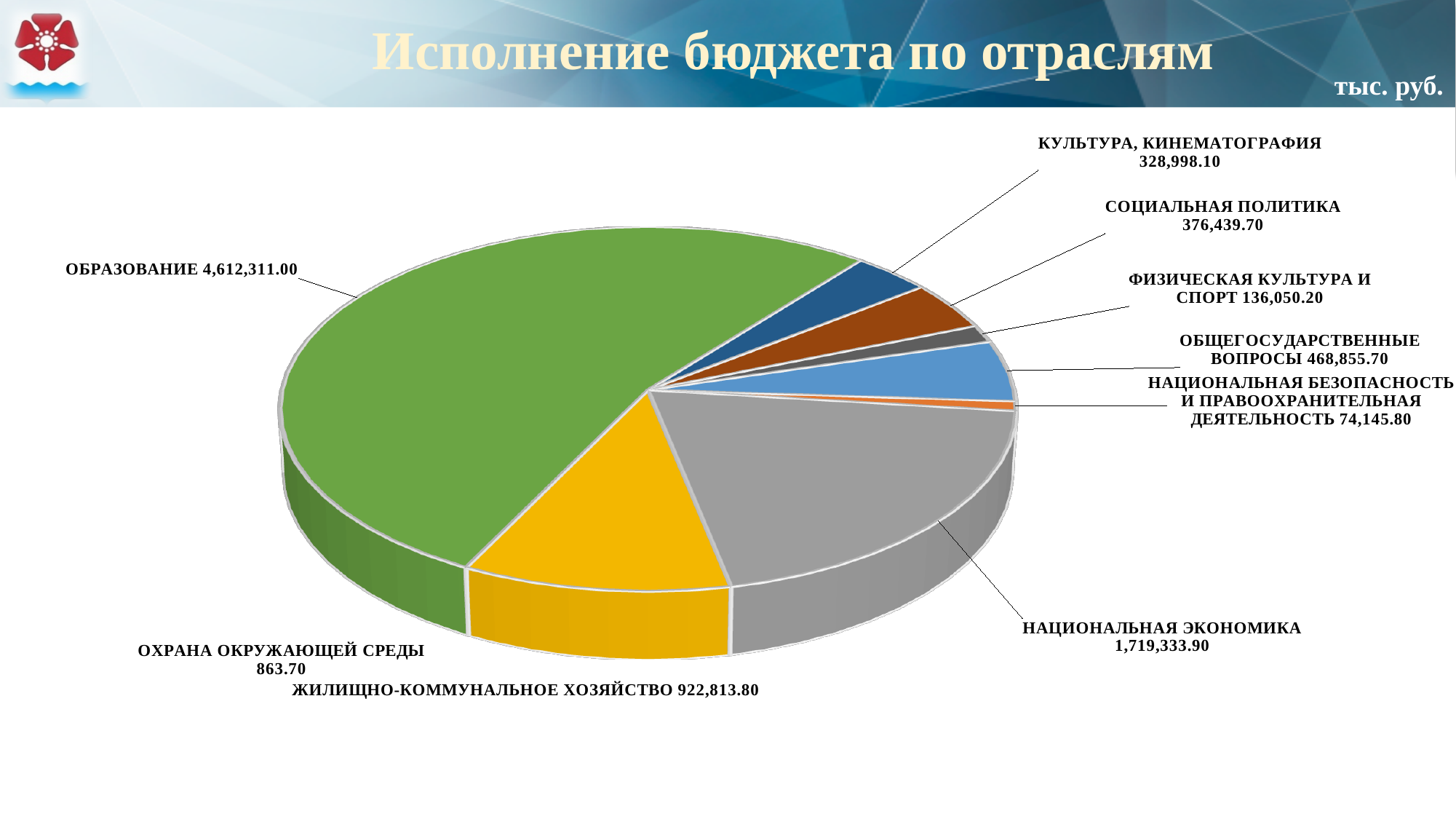
What is the difference between ОБЩЕГОСУДАРСТВЕННЫЕ ВОПРОСЫ and ФИЗИЧЕСКАЯ КУЛЬТУРА И СПОРТ? 332,805.50 What is the value for НАЦИОНАЛЬНАЯ ЭКОНОМИКА? 1,719,333.90 Which category has the largest value? ОБРАЗОВАНИЕ What kind of chart is shown on the slide? Pie chart In what units are the values on the chart given? тыс. руб. What is the value for ОБРАЗОВАНИЕ? 4,612,311.00 What is the value for ФИЗИЧЕСКАЯ КУЛЬТУРА И СПОРТ? 136,050.20 What is the title of the chart? Исполнение бюджета по отраслям What is the difference between НАЦИОНАЛЬНАЯ ЭКОНОМИКА and ЖИЛИЩНО-КОММУНАЛЬНОЕ ХОЗЯЙСТВО? 796,520.10 Which category has the smallest value? ОХРАНА ОКРУЖАЮЩЕЙ СРЕДЫ How many categories (slices) does the pie chart have? 9 Which is larger: СОЦИАЛЬНАЯ ПОЛИТИКА or КУЛЬТУРА, КИНЕМАТОГРАФИЯ? СОЦИАЛЬНАЯ ПОЛИТИКА